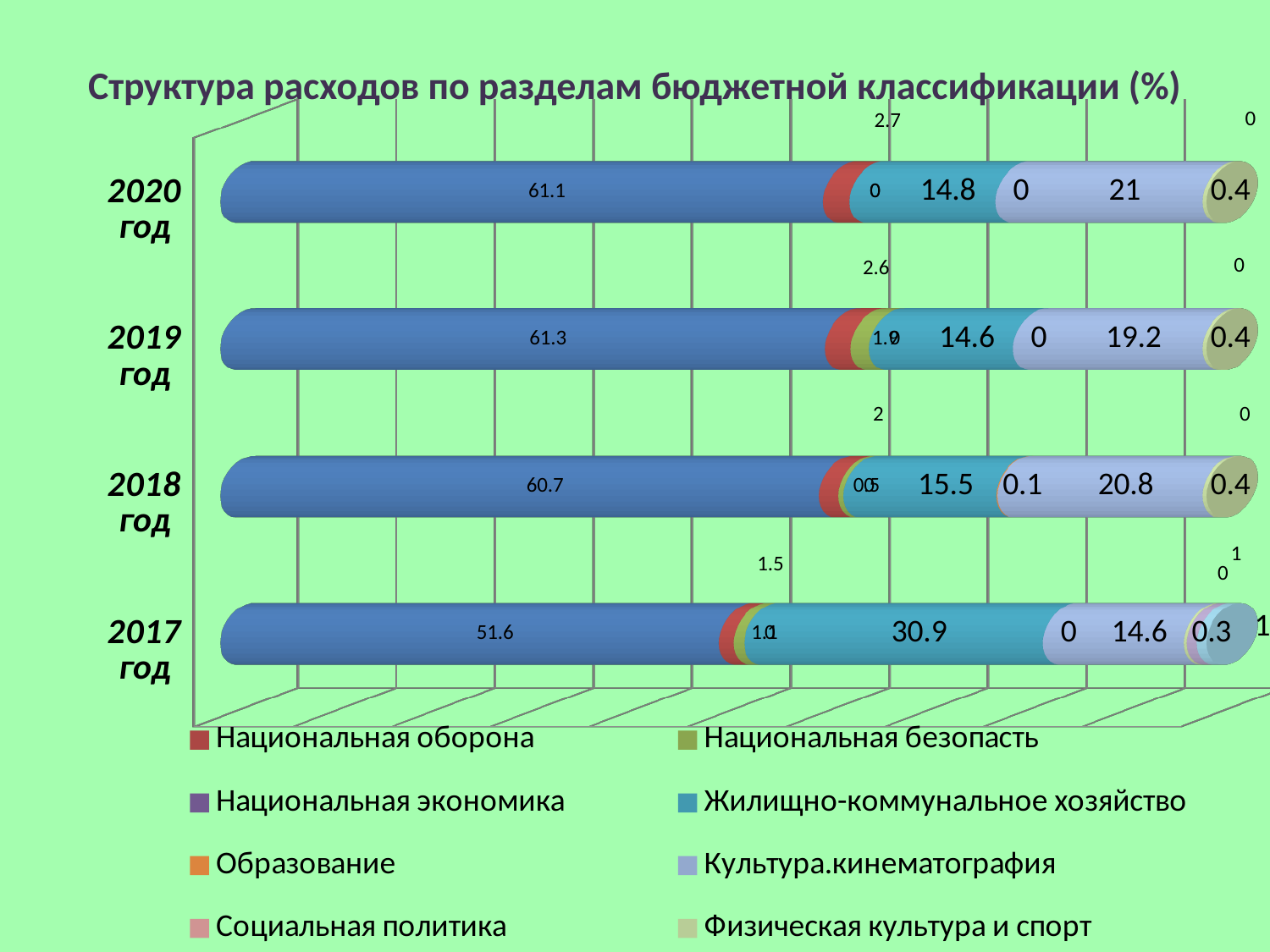
In which year is the value for Жилищно-коммунальное хозяйство the highest? 2017 год In which year is the value for Культура.кинематография the lowest? 2017 год What value is printed on the leftmost (largest) segment of the 2017 год bar? 51.6 How many years (categories) are shown on the chart? 4 What kind of chart is shown on the slide? bar chart What is the value for Физическая культура и спорт in 2017 год? 0.3 What is the value for Жилищно-коммунальное хозяйство in 2017 год? 30.9 Which year has the larger value for Культура.кинематография, 2018 год or 2019 год? 2018 год What is the difference between the Жилищно-коммунальное хозяйство values for 2018 год and 2019 год? 0.9 How many series does the legend list? 8 What is the title of the chart? Структура расходов по разделам бюджетной классификации (%) What is the value for Культура.кинематография in 2020 год? 21